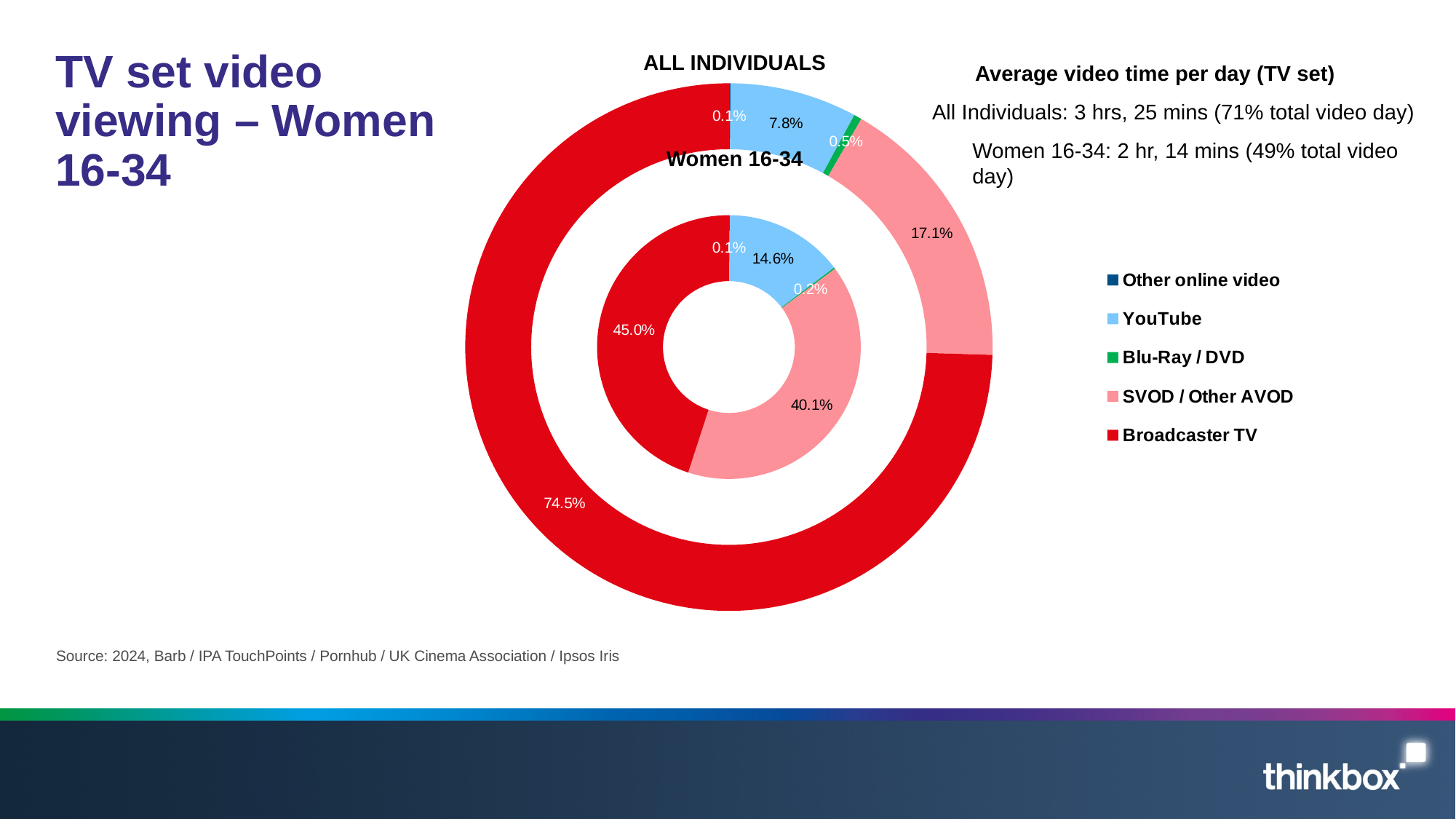
What kind of chart is shown on the slide? Doughnut chart In the All Individuals ring, what share of TV set video viewing is Broadcaster TV? 74.5% In the Women 16-34 ring, what share is YouTube? 14.6% Which category has the smallest share in the All Individuals ring? Other online video In the Women 16-34 ring, what share of TV set video viewing is SVOD / Other AVOD? 40.1% In the All Individuals ring, what share is Blu-Ray / DVD? 0.5% Which colour represents SVOD / Other AVOD in the chart? Light pink How many categories does the legend list? 5 What is the difference between the Broadcaster TV share for All Individuals and for Women 16-34? 29.5 percentage points Which ring of the doughnut chart represents Women 16-34, the inner or the outer? Inner Is the YouTube share larger for All Individuals or for Women 16-34? Women 16-34 Which category has the largest share in the Women 16-34 ring? Broadcaster TV